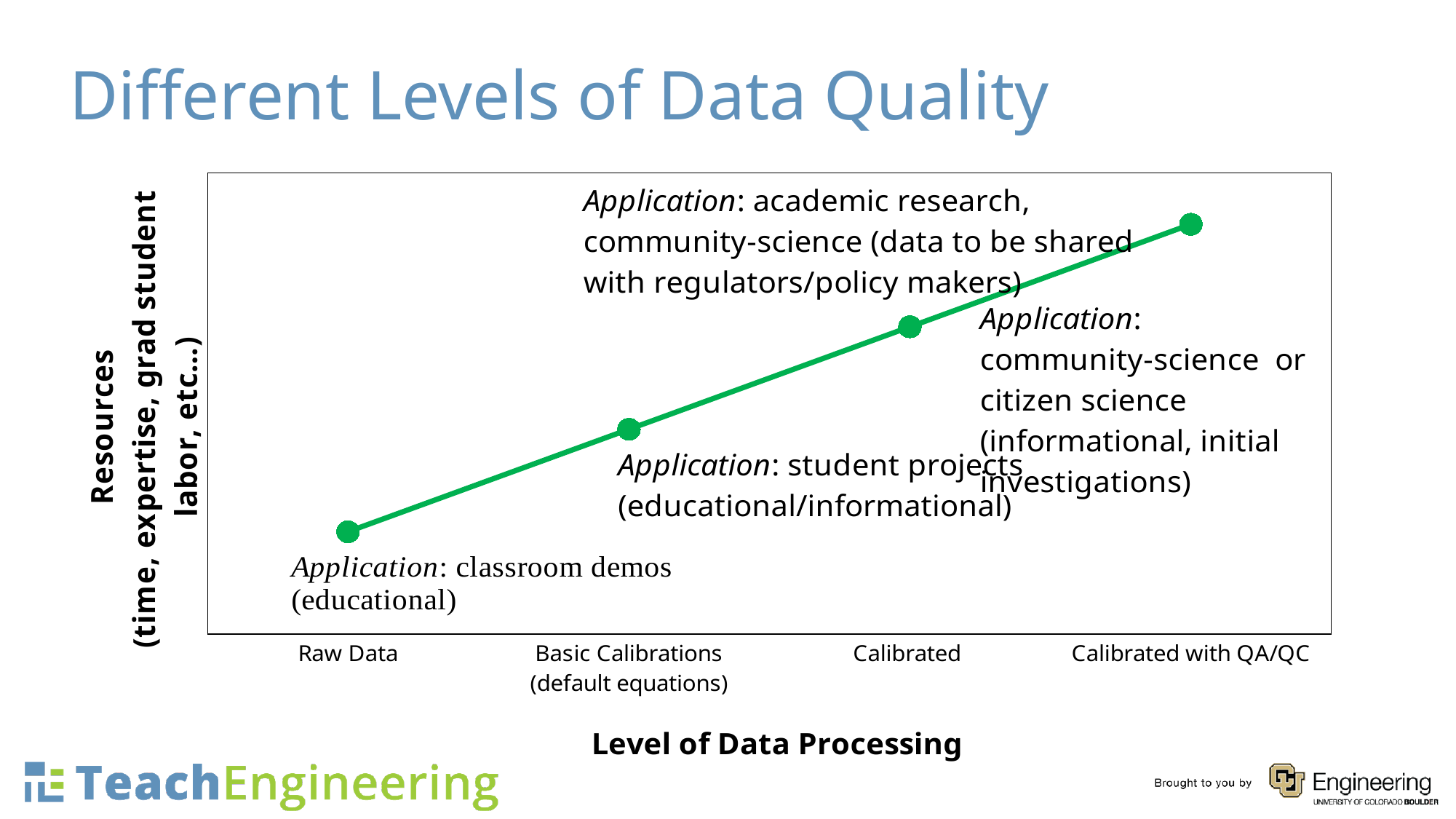
What application is listed for the Raw Data level? classroom demos (educational) Which level of data processing has the lowest resources value? Raw Data Which requires more resources, Basic Calibrations (default equations) or Calibrated? Calibrated What is the title of the x axis? Level of Data Processing Which level of data processing has the highest resources value? Calibrated with QA/QC How many data points are plotted on the line? 4 Do the values rise or fall as the level of data processing increases along the x axis? rise Which requires fewer resources, Raw Data or Calibrated with QA/QC? Raw Data What is the label of the second category on the x axis? Basic Calibrations (default equations) What kind of chart is shown on the slide? line chart